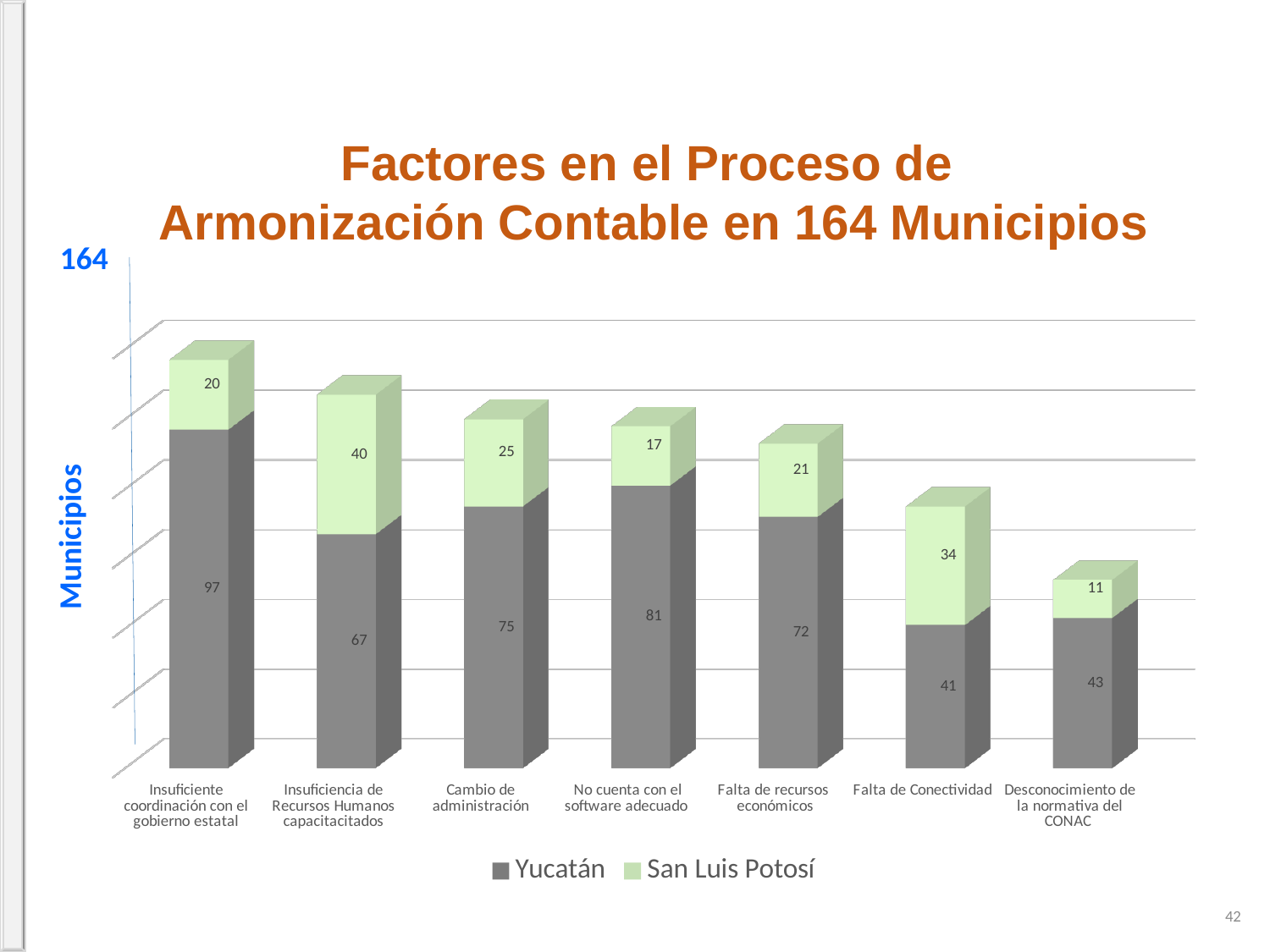
Which category has the highest Yucatán value? Insuficiente coordinación con el gobierno estatal What is the San Luis Potosí value for 'Insuficiencia de Recursos Humanos capacitacitados'? 40 What is the Yucatán value for 'Falta de Conectividad'? 41 What is the total of the stacked bar for 'Cambio de administración'? 100 Which category has the lowest San Luis Potosí value? Desconocimiento de la normativa del CONAC What is the Yucatán value for 'Insuficiente coordinación con el gobierno estatal'? 97 Which is larger: the San Luis Potosí value for 'Falta de Conectividad' or for 'Falta de recursos económicos'? Falta de Conectividad What type of chart is shown on the slide? Stacked bar chart How many series does the legend list? 2 How many categories (factors) are shown on the x axis? 7 What is the difference between the Yucatán and San Luis Potosí values for 'No cuenta con el software adecuado'? 64 What is the title of the chart? Factores en el Proceso de Armonización Contable en 164 Municipios